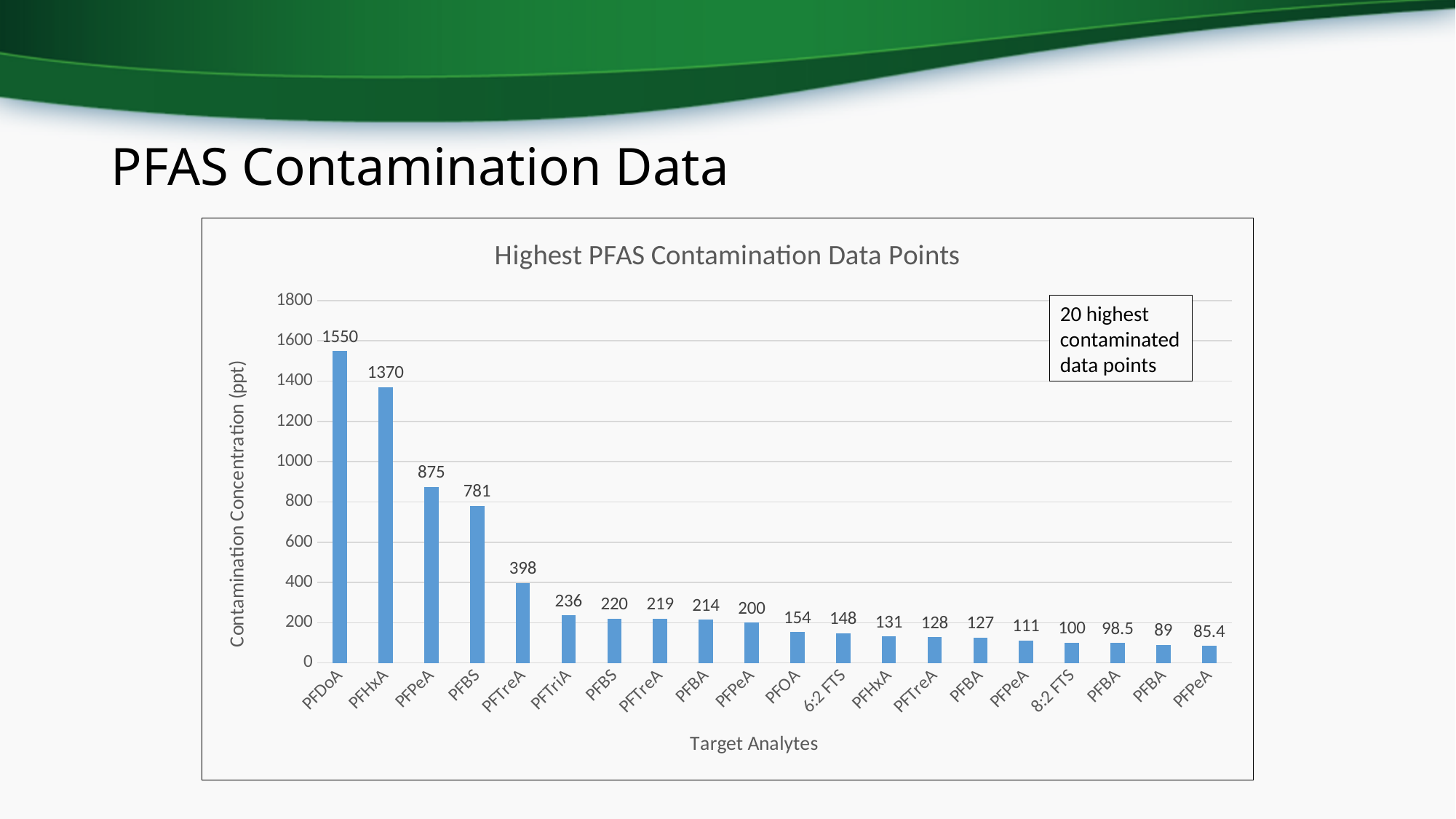
What is the title of the chart? Highest PFAS Contamination Data Points How many bars are plotted in the chart? 20 What is the contamination concentration for 8:2 FTS? 100 Which has a larger value, PFOA or 8:2 FTS? PFOA Which target analyte has the highest contamination concentration? PFDoA What is the contamination concentration for PFTriA? 236 What is the contamination concentration for 6:2 FTS? 148 What type of chart is shown on the slide? bar chart What is the lowest value shown in the chart? 85.4 What is the contamination concentration for PFOA? 154 What is the difference between the values for PFDoA and PFTriA? 1314 What is the contamination concentration for PFDoA? 1550